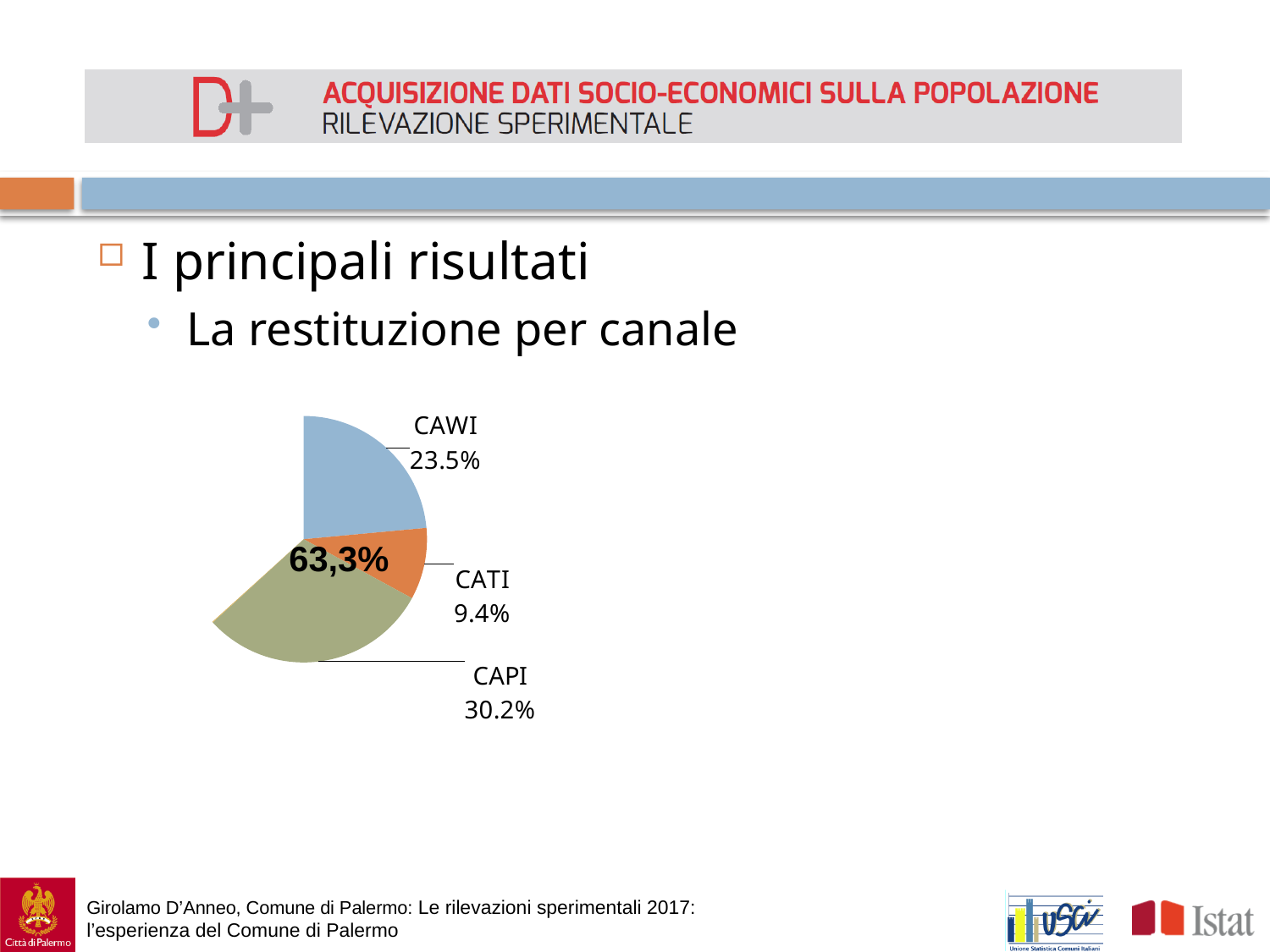
What is the difference in percentage points between the CAWI share and the CATI share? 14.1 What is the value shown for the CAWI slice? 23.5% What kind of chart is shown on the slide? pie chart What is the value shown for the CAPI slice? 30.2% Which labeled channel has the smallest share in the pie chart? CATI Which is larger, the share for CAPI or the share for CAWI? CAPI What is the difference in percentage points between the CAPI share and the CAWI share? 6.7 How many labeled slices does the pie chart have? 3 Which labeled channel has the largest share in the pie chart? CAPI What bold percentage is printed over the pie chart? 63,3% What is the value shown for the CATI slice? 9.4% Which is larger, the share for CAWI or the share for CATI? CAWI